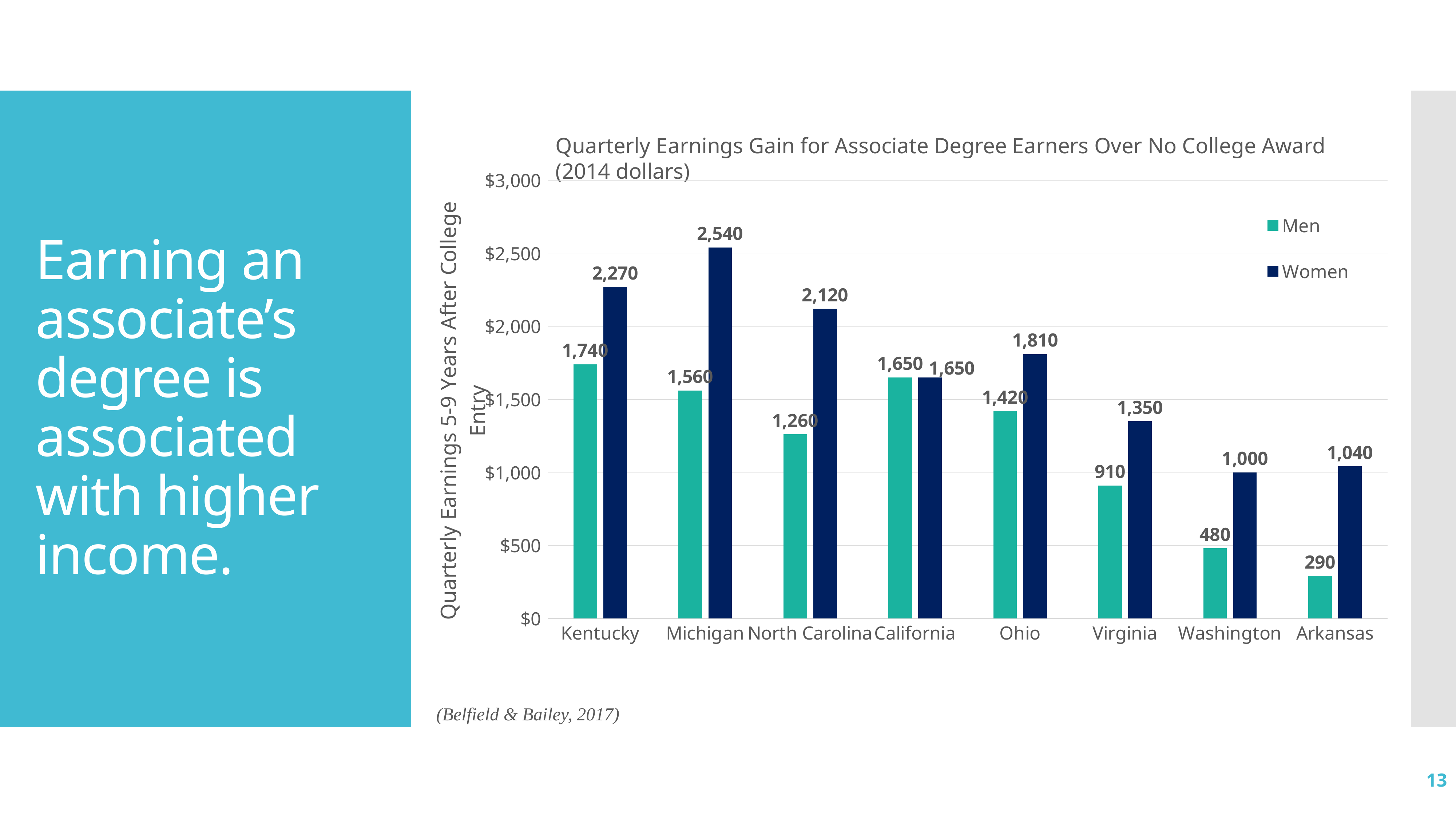
What is the difference between the Women and Men values in North Carolina? 860 How many states are shown on the x axis? 8 Which state has the highest value for Women? Michigan Is the value for Women in Washington greater or less than $500? greater What is the value for Men in Arkansas? 290 What is the value for Men in Ohio? 1,420 What kind of chart is shown on the slide? bar chart Which is larger in Virginia, the value for Men or the value for Women? Women What is the title of the chart? Quarterly Earnings Gain for Associate Degree Earners Over No College Award (2014 dollars) How many series does the legend list? 2 Which state has the lowest value for Men? Arkansas What is the value for Women in Michigan? 2,540